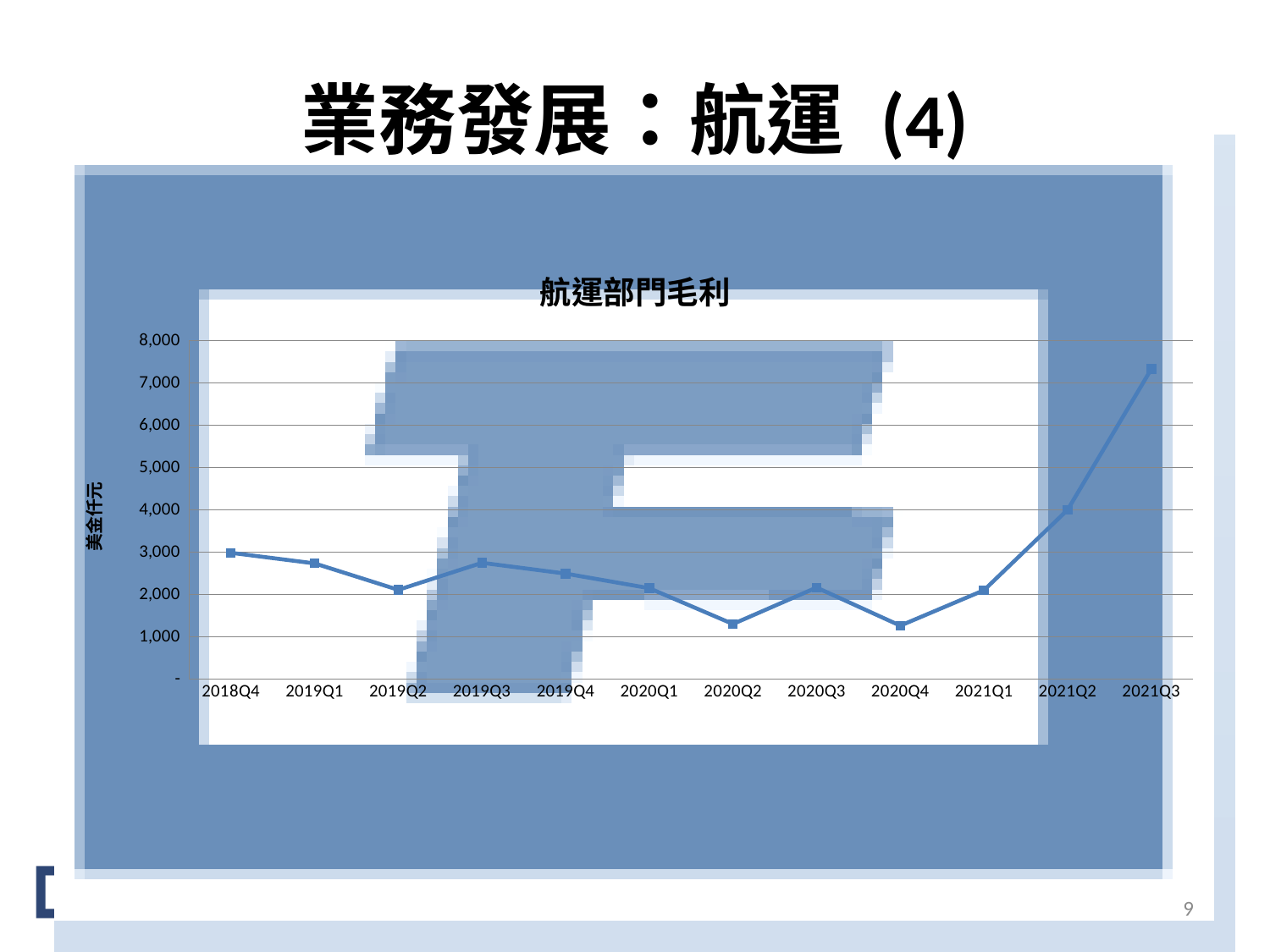
Which quarter has the highest value? 2021Q3 What kind of chart is shown on the slide? line chart What is the title of the chart? 航運部門毛利 Is the value for 2018Q4 greater or less than 2,000? greater How many quarters are plotted along the x axis? 12 Do the values rise or fall from 2021Q1 to 2021Q3? rise Which is larger, the value for 2021Q2 or the value for 2021Q1? 2021Q2 Is the value for 2020Q4 greater or less than 2,000? less What is the label on the vertical axis of the chart? 美金仟元 Which is larger, the value for 2018Q4 or the value for 2020Q2? 2018Q4 Is the value for 2021Q3 greater or less than 7,000? greater